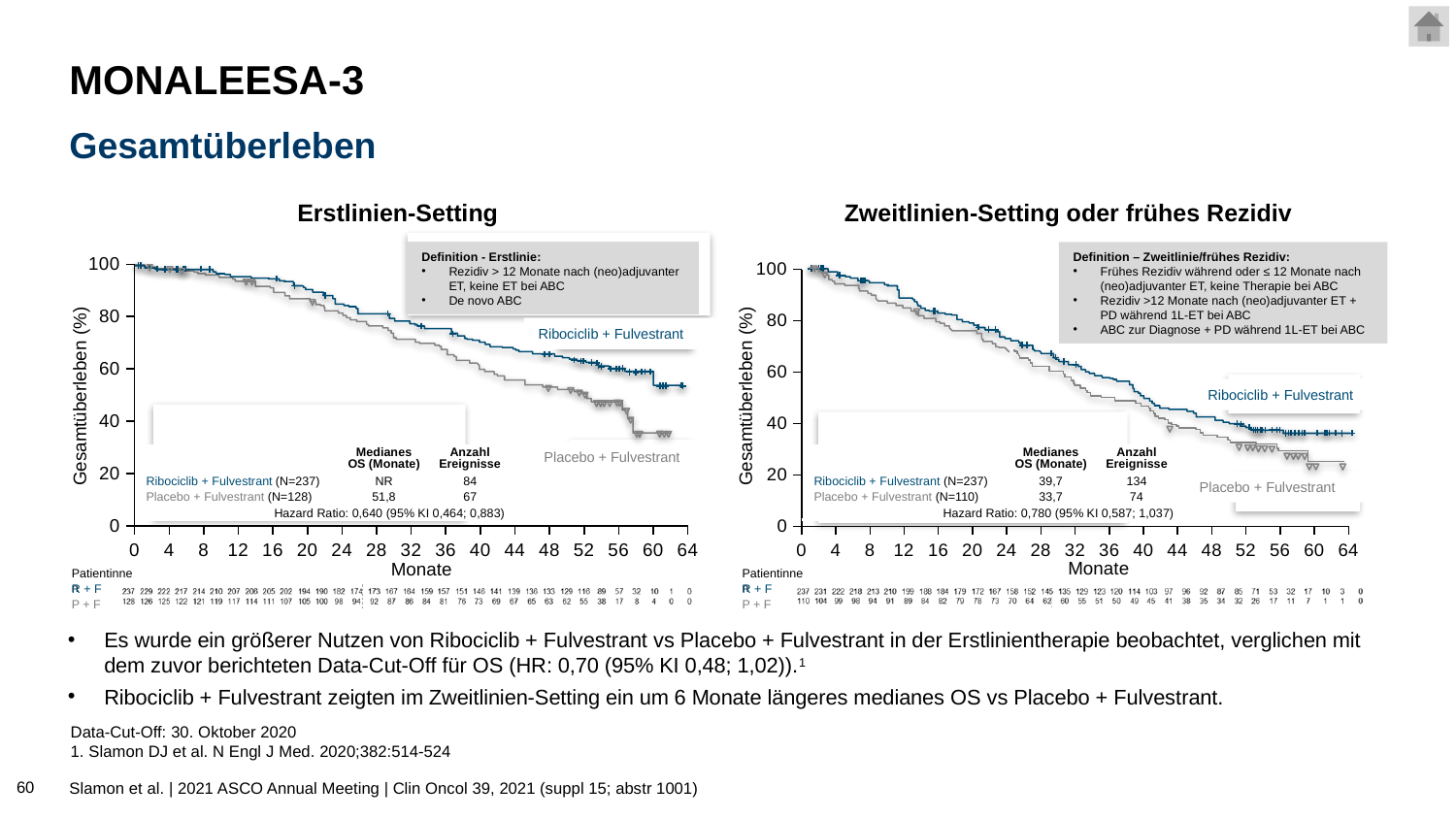
What kind of chart is used for the Erstlinien-Setting panel? Line chart (Kaplan-Meier curve) On the Zweitlinien-Setting oder frühes Rezidiv chart, which arm has more events: Ribociclib + Fulvestrant or Placebo + Fulvestrant? Ribociclib + Fulvestrant On the Zweitlinien-Setting oder frühes Rezidiv chart, what is the median OS (months) for Ribociclib + Fulvestrant? 39,7 On the Erstlinien-Setting chart, what is the difference in the number of events between Ribociclib + Fulvestrant and Placebo + Fulvestrant? 17 On the Erstlinien-Setting chart, what is the hazard ratio shown? 0,640 (95% KI 0,464; 0,883) On the Erstlinien-Setting chart, what is the median OS for Ribociclib + Fulvestrant? NR On the Erstlinien-Setting chart, is the Placebo + Fulvestrant curve at 48 months greater or less than 40%? greater On the Erstlinien-Setting chart, how many events (Anzahl Ereignisse) are reported for Ribociclib + Fulvestrant? 84 On the Erstlinien-Setting chart, what is the median OS (months) for Placebo + Fulvestrant? 51,8 On the Zweitlinien-Setting oder frühes Rezidiv chart, how many patients (N) are in the Placebo + Fulvestrant arm? 110 On the Zweitlinien-Setting oder frühes Rezidiv chart, what is the median OS (months) for Placebo + Fulvestrant? 33,7 On the Zweitlinien-Setting oder frühes Rezidiv chart, is the Ribociclib + Fulvestrant curve at 60 months greater or less than 40%? less